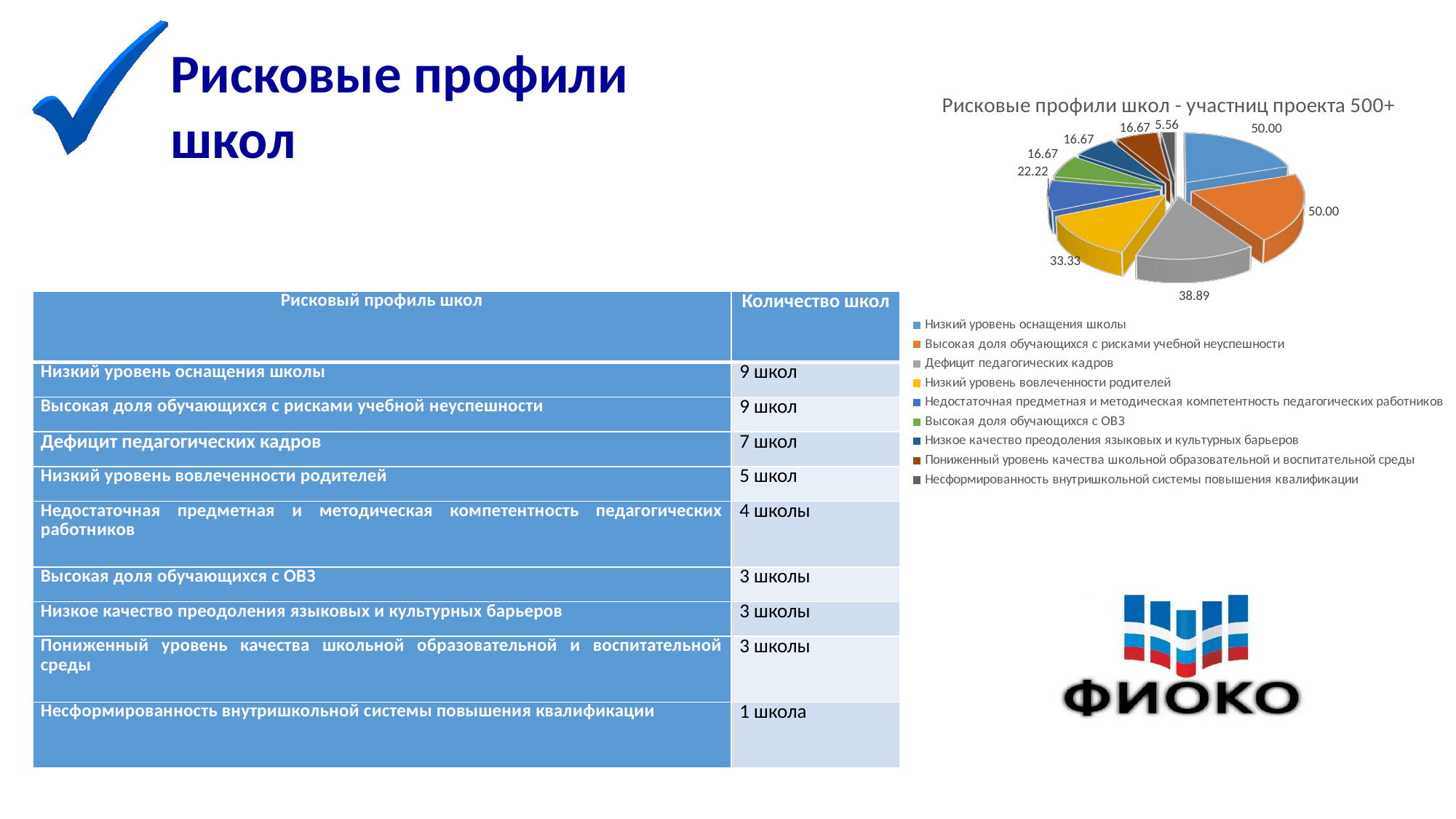
How many entries does the legend of the pie chart list? 9 What value is labelled on the slice for 'Низкий уровень оснащения школы'? 50.00 How many slices does the pie chart have? 9 What is the difference between the labelled values for 'Высокая доля обучающихся с рисками учебной неуспешности' and 'Дефицит педагогических кадров'? 11.11 What value is labelled on the slice for 'Дефицит педагогических кадров'? 38.89 What is the title of the pie chart? Рисковые профили школ - участниц проекта 500+ What value is labelled on the slice for 'Несформированность внутришкольной системы повышения квалификации'? 5.56 What kind of chart is shown on the slide? pie chart What value is labelled on the slice for 'Низкий уровень вовлеченности родителей'? 33.33 Which slice is larger: 'Дефицит педагогических кадров' or 'Низкий уровень вовлеченности родителей'? Дефицит педагогических кадров Which category has the smallest slice in the pie chart? Несформированность внутришкольной системы повышения квалификации What value is labelled on the slice for 'Недостаточная предметная и методическая компетентность педагогических работников'? 22.22